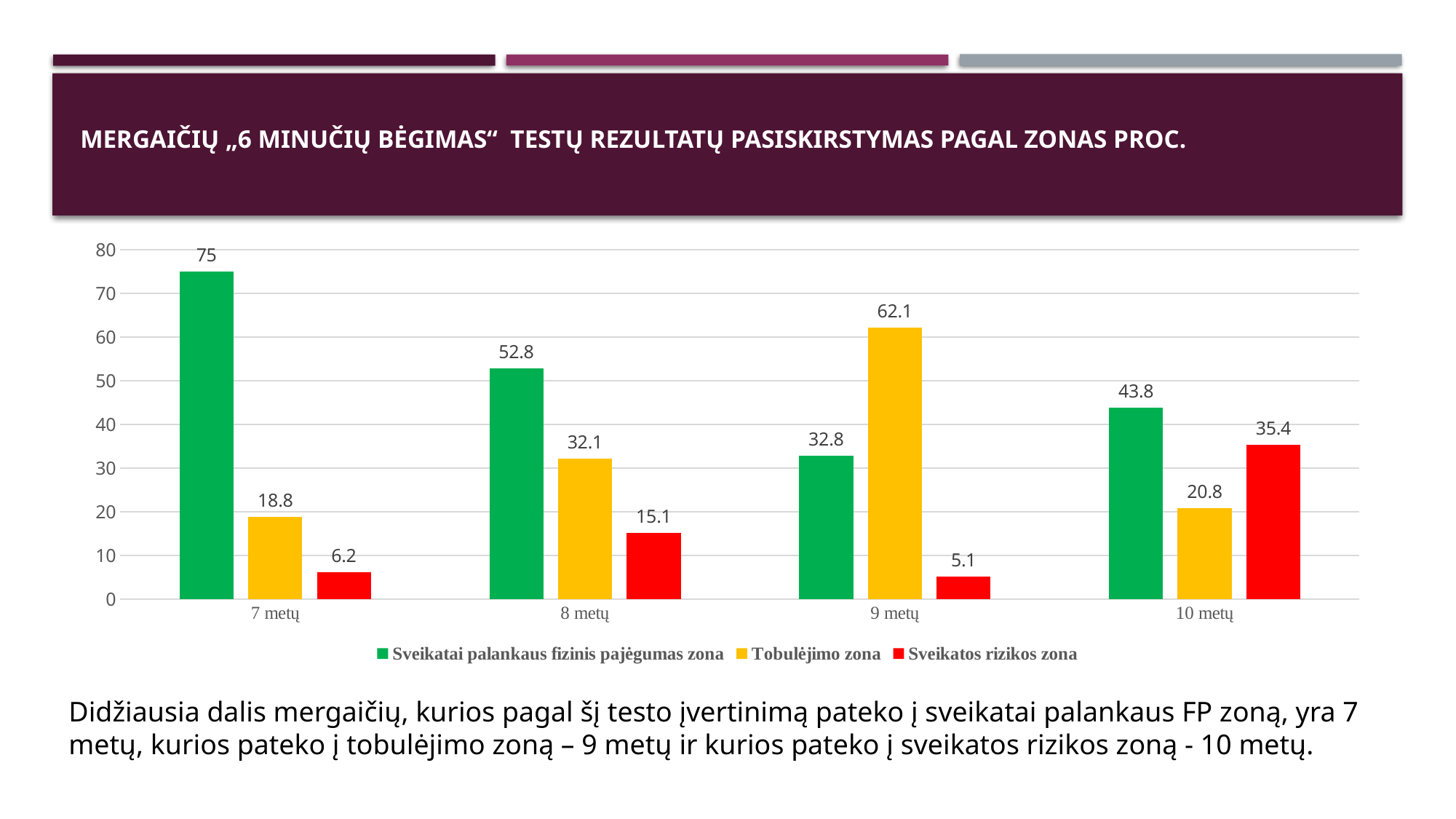
Which age group has the lowest value for 'Sveikatai palankaus fizinis pajėgumas zona'? 9 metų What is the value for 'Sveikatos rizikos zona' for 10 metų? 35.4 What is the value for 'Sveikatai palankaus fizinis pajėgumas zona' for 7 metų? 75 Which age group has the highest value for 'Sveikatos rizikos zona'? 10 metų What is the difference between the 'Sveikatai palankaus fizinis pajėgumas zona' values for 7 metų and 8 metų? 22.2 What kind of chart is shown on the slide? Bar chart How many series does the legend list? 3 What is the value for 'Tobulėjimo zona' for 9 metų? 62.1 Which is larger for 10 metų: 'Tobulėjimo zona' or 'Sveikatos rizikos zona'? Sveikatos rizikos zona What is the value for 'Tobulėjimo zona' for 8 metų? 32.1 How many age groups are shown on the x axis? 4 Does the value for 'Sveikatos rizikos zona' rise or fall from 9 metų to 10 metų? Rise